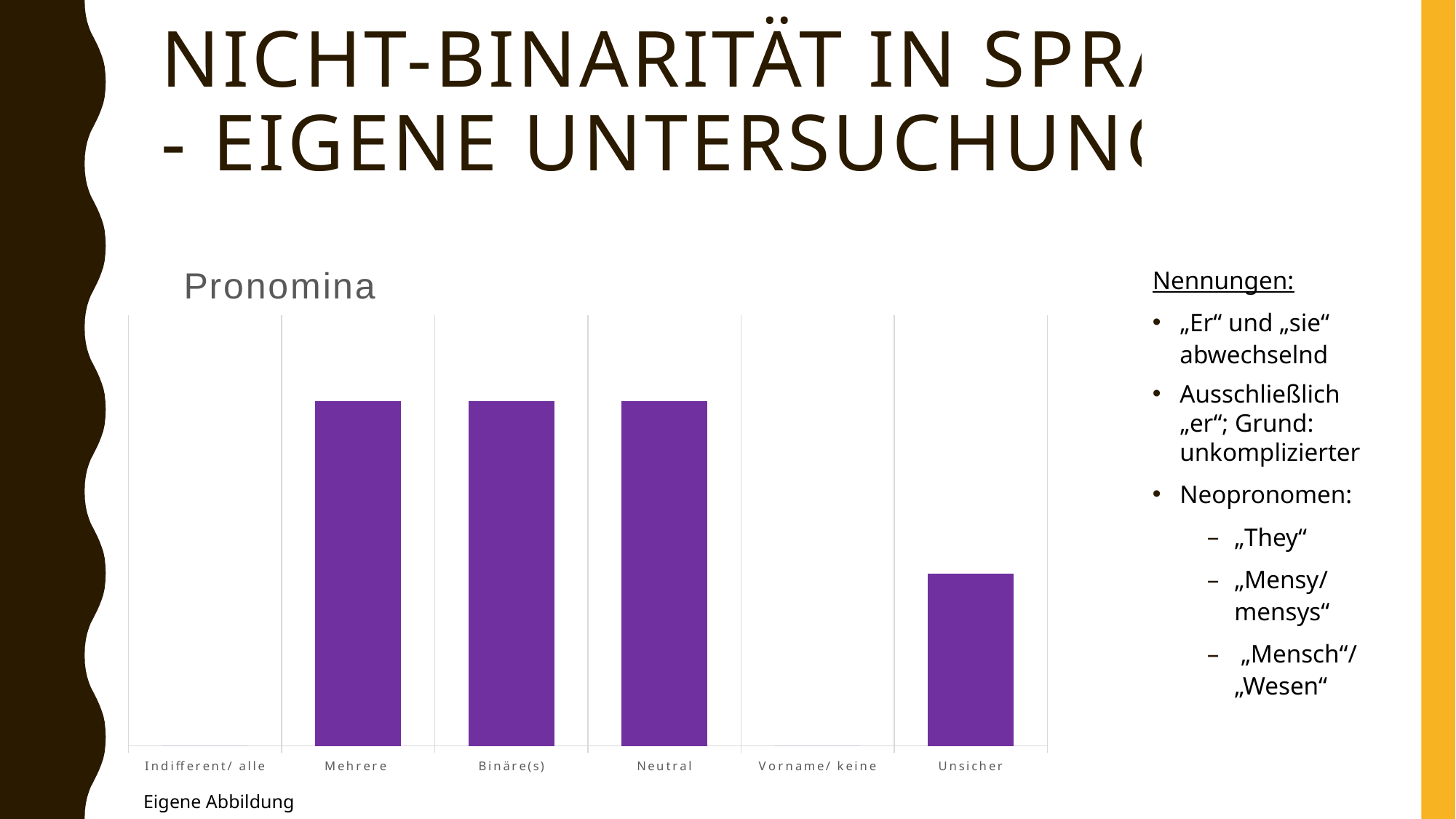
What is the title of the chart? Pronomina What is the label of the last category on the x axis? Unsicher Among the categories with a visible bar, which has the lowest value? Unsicher How many categories are listed on the x axis of the chart? 6 What is the label of the first category on the x axis? Indifferent/ alle Which is larger, the value for Binäre(s) or the value for Unsicher? Binäre(s) Which is larger, the value for Mehrere or the value for Unsicher? Mehrere What kind of chart is shown on the slide? bar chart Which is larger, the value for Neutral or the value for Unsicher? Neutral